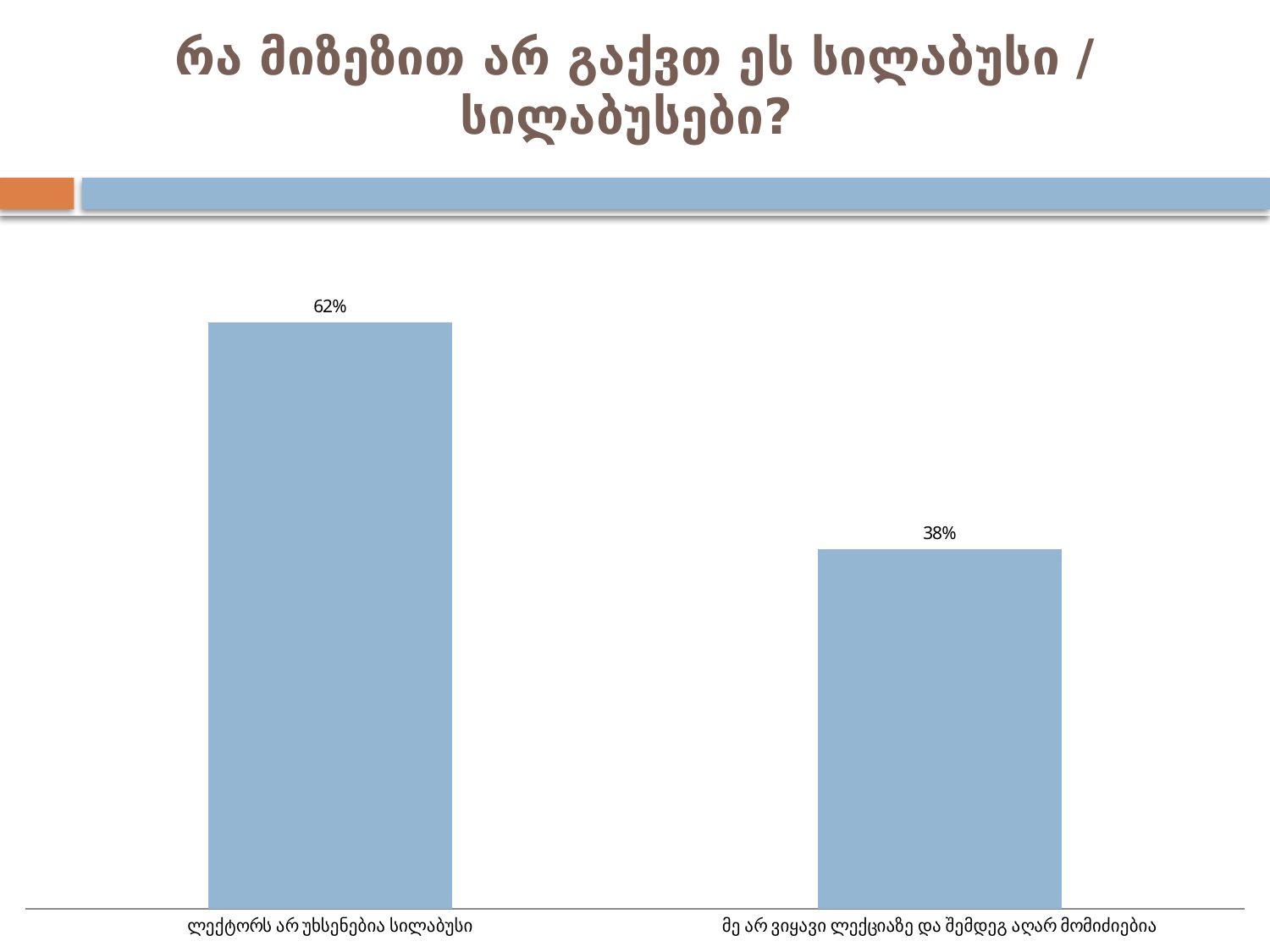
What is the title of the slide containing the chart? რა მიზეზით არ გაქვთ ეს სილაბუსი / სილაბუსები? What colour are the bars in the chart? Light blue How many categories are shown in the chart? 2 Which category has the lowest value? მე არ ვიყავი ლექციაზე და შემდეგ აღარ მომიძიებია Do the values rise or fall from left to right across the categories? Fall Which is larger: the value for "ლექტორს არ უხსენებია სილაბუსი" or the value for "მე არ ვიყავი ლექციაზე და შემდეგ აღარ მომიძიებია"? ლექტორს არ უხსენებია სილაბუსი What kind of chart is shown on the slide? Bar chart What is the difference between the values for "ლექტორს არ უხსენებია სილაბუსი" and "მე არ ვიყავი ლექციაზე და შემდეგ აღარ მომიძიებია"? 24% Which category has the highest value? ლექტორს არ უხსენებია სილაბუსი What value is shown for the category "ლექტორს არ უხსენებია სილაბუსი"? 62% What is the total of the two values shown in the chart? 100% What value is shown for the category "მე არ ვიყავი ლექციაზე და შემდეგ აღარ მომიძიებია"? 38%